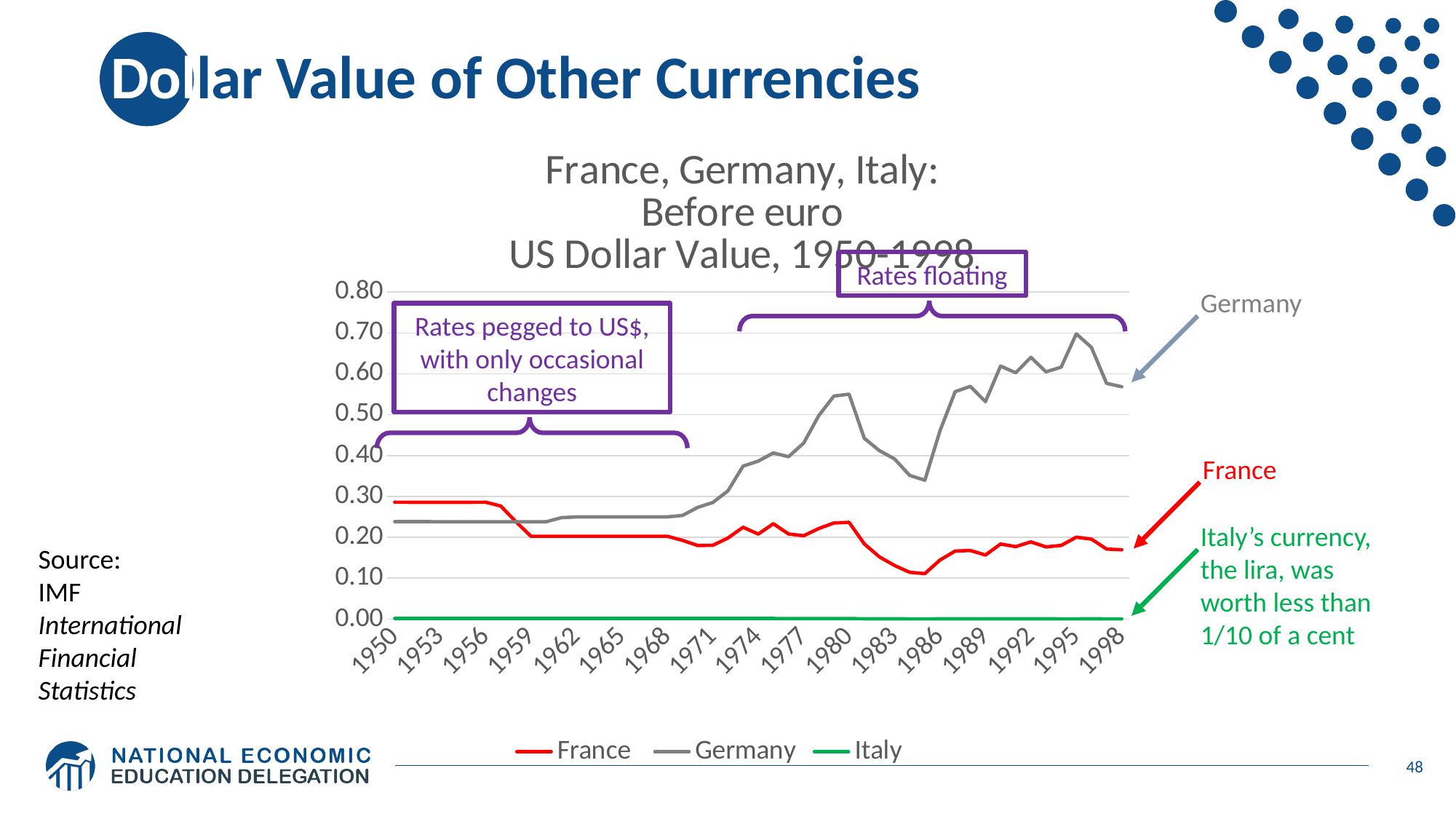
How many series does the chart legend list? 3 Which series has the lowest value across the whole chart? Italy Is the value for Germany in 1995 greater or less than 0.60? greater How many year labels are shown on the x axis? 17 Which series has the highest value in 1998? Germany Does the value for Germany generally rise or fall from 1950 to 1998? rise What kind of chart is shown on the slide? line chart Is the value for Germany in 1950 greater or less than 0.30? less What is the title of the chart? France, Germany, Italy: Before euro US Dollar Value, 1950-1998 Which currencies are listed in the chart legend? France, Germany, Italy Is the value for France in 1986 greater or less than 0.20? less Which is larger in 1998, the value for France or the value for Germany? Germany